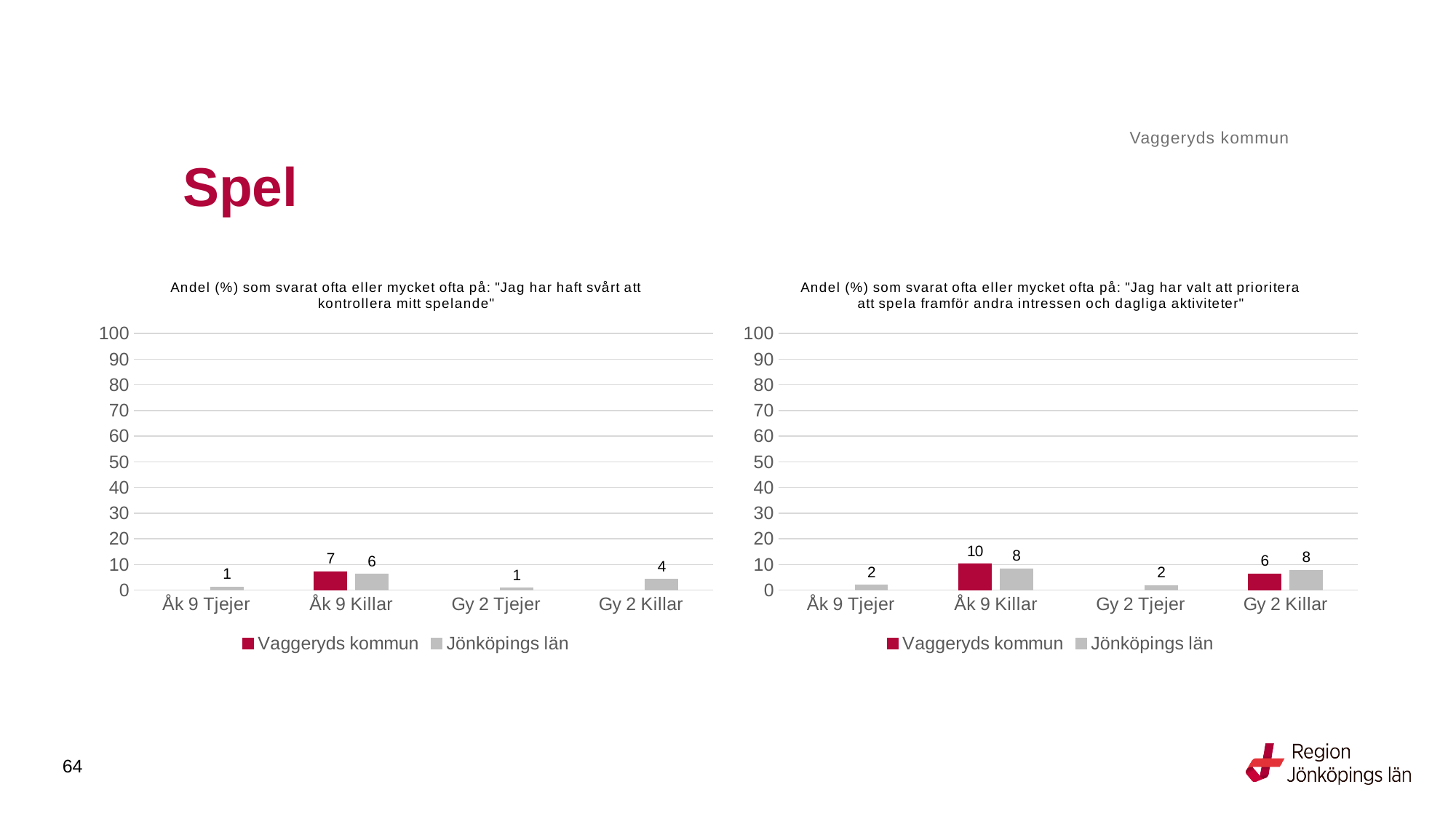
In the right chart, what is the value for Jönköpings län for Gy 2 Killar? 8 In the left chart, what is the value for Vaggeryds kommun for Åk 9 Killar? 7 In the left chart, what is the value for Jönköpings län for Gy 2 Killar? 4 In the right chart, what is the value for Vaggeryds kommun for Åk 9 Killar? 10 In the left chart, is the value for Jönköpings län for Åk 9 Killar greater or less than 10? less What type of chart is the left chart? Bar chart In the right chart, for Gy 2 Killar, which is larger: Vaggeryds kommun or Jönköpings län? Jönköpings län In the left chart, which category has the highest value for Jönköpings län? Åk 9 Killar How many categories are shown on the x axis of the right chart? 4 How many series does the legend of the left chart list? 2 In the right chart, which category has the highest value for Jönköpings län? Åk 9 Killar and Gy 2 Killar (both 8) In the right chart, what is the difference between Vaggeryds kommun and Jönköpings län for Åk 9 Killar? 2